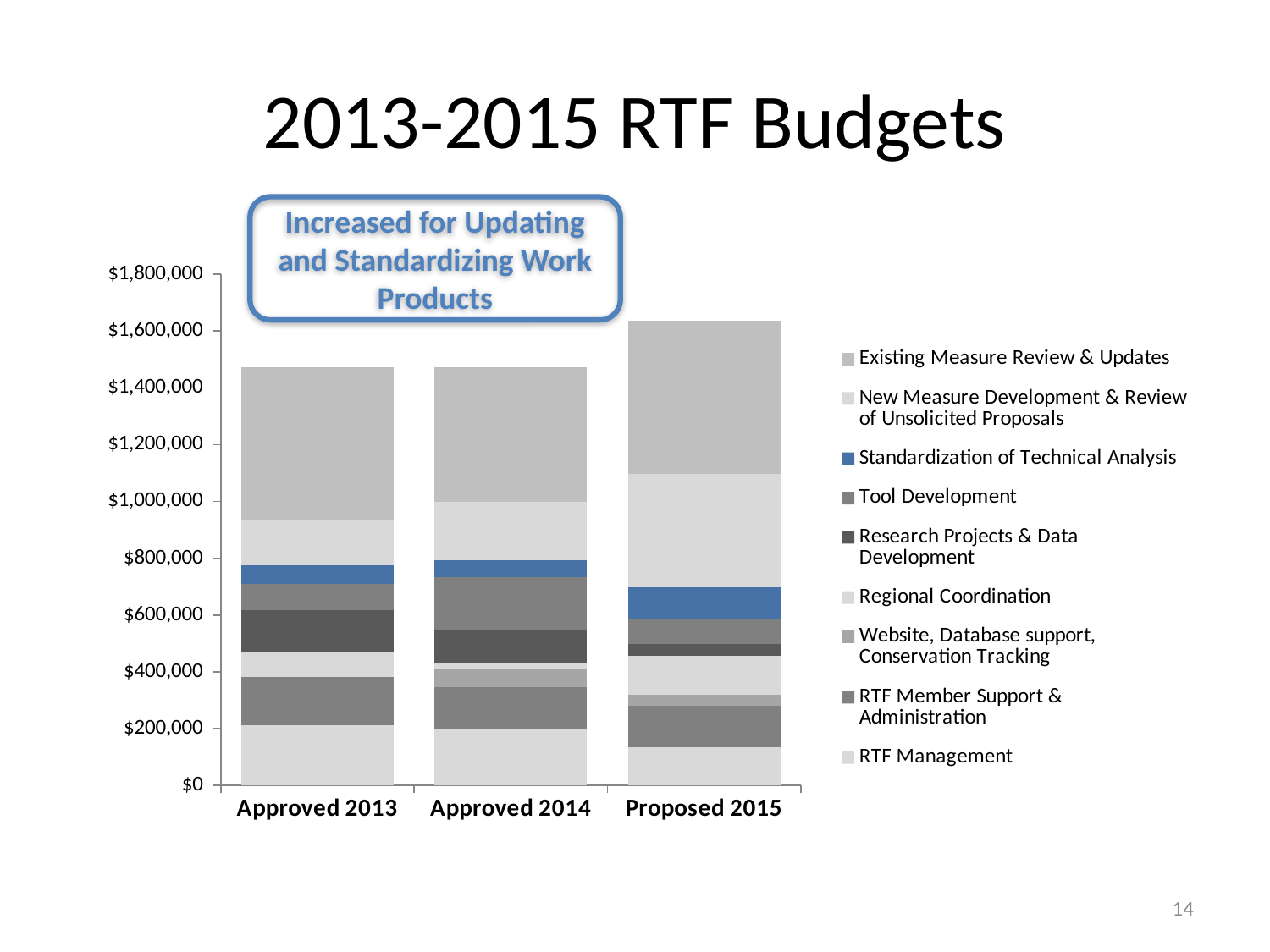
Is the total for Approved 2013 greater or less than $1,600,000? less Is the Standardization of Technical Analysis segment larger in Proposed 2015 or in Approved 2013? Proposed 2015 Which total is larger, Proposed 2015 or Approved 2014? Proposed 2015 What does the callout box above the chart say? Increased for Updating and Standardizing Work Products Is the total for Approved 2014 greater or less than $1,400,000? greater How many budget years (categories) are shown on the x axis? 3 What kind of chart is shown on the slide? stacked bar chart Is the total for Proposed 2015 greater or less than $1,600,000? greater Do the total budgets rise or fall from Approved 2013 to Proposed 2015? rise What is the title of the chart slide? 2013-2015 RTF Budgets Which budget year has the highest total bar? Proposed 2015 How many series does the legend list? 9